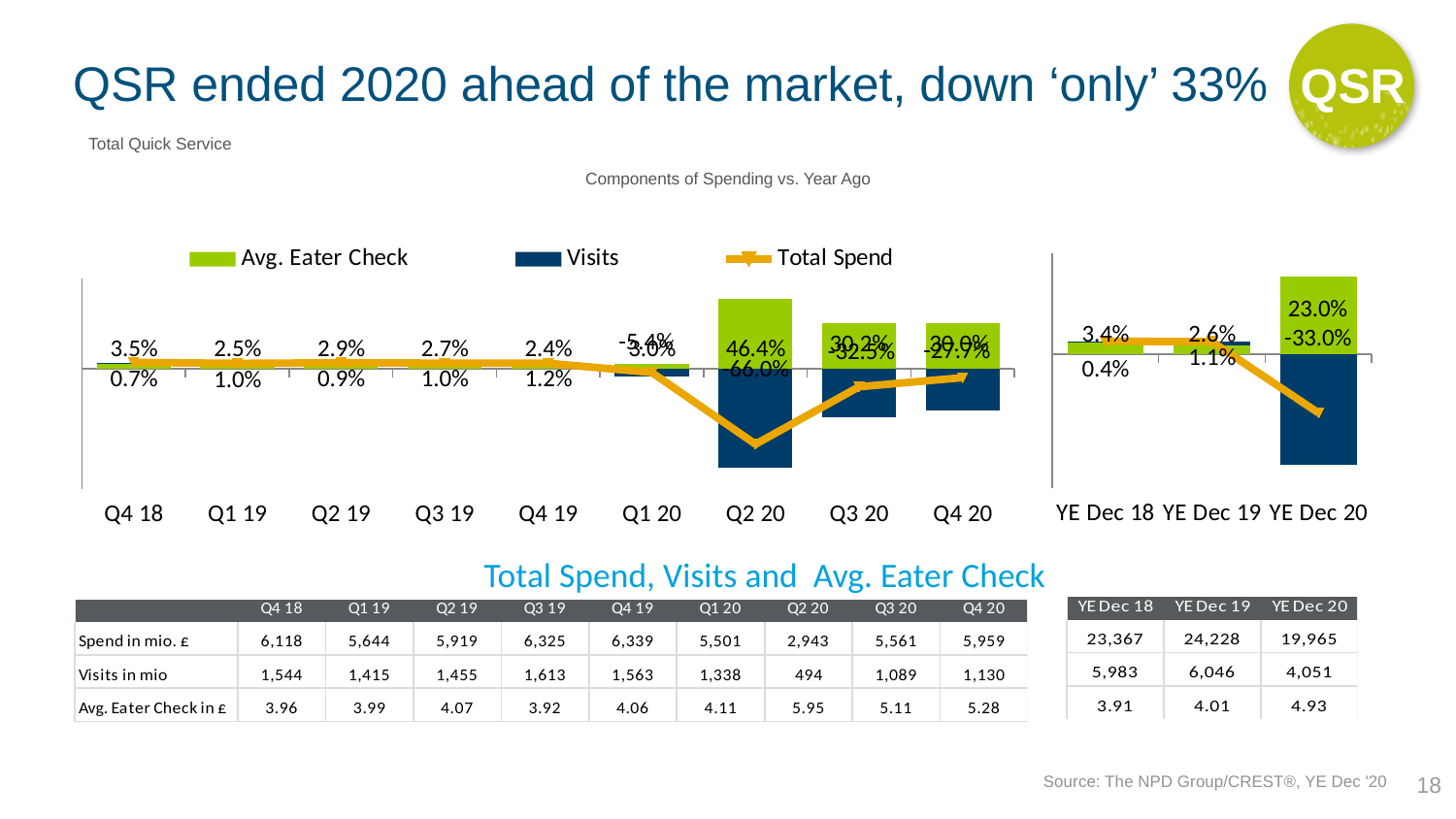
On the left quarterly chart, which is larger: the Visits value for Q4 19 or for Q1 19? Q4 19 On the right yearly chart, what is the Avg. Eater Check value for YE Dec 18? 3.4% On the left quarterly chart, what is the Visits value for Q2 20? -66.0% On the left quarterly chart, what is the Visits value for Q4 19? 1.2% On the right yearly chart, what is the Visits value for YE Dec 20? -33.0% How many series does the legend list for the charts? 3 On the right yearly chart, what is the difference between the Visits values for YE Dec 19 and YE Dec 18? 0.7 percentage points On the left quarterly chart, which quarter has the highest Avg. Eater Check value? Q2 20 On the left quarterly chart, what is the Avg. Eater Check value for Q4 18? 3.5% On the left quarterly chart, which quarter has the lowest Visits value? Q2 20 On the left quarterly chart, what is the Avg. Eater Check value for Q2 20? 46.4% How many quarters are shown on the x axis of the left quarterly chart? 9